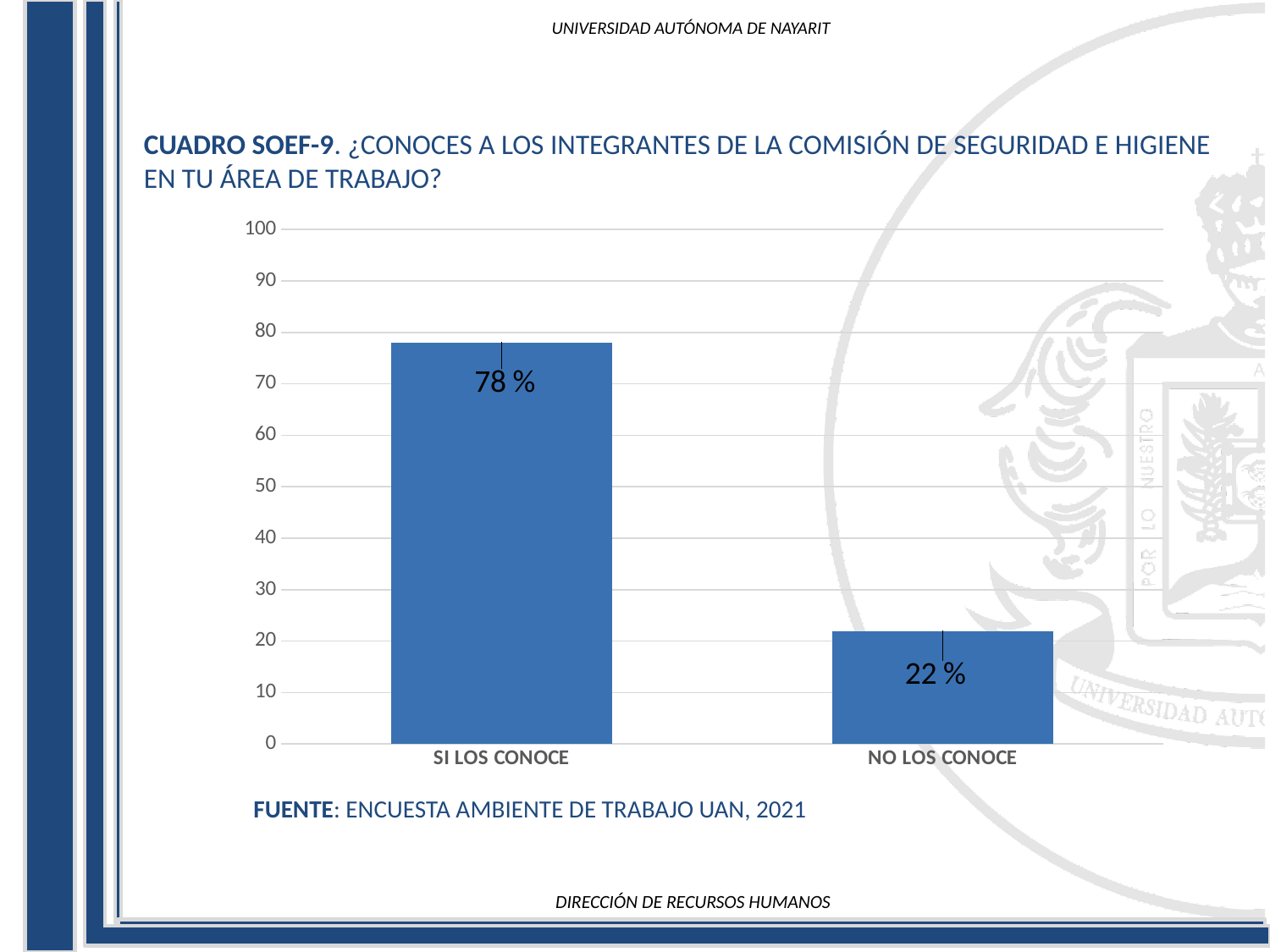
Is the value for SI LOS CONOCE greater or less than 70? greater Which is larger, the value for SI LOS CONOCE or the value for NO LOS CONOCE? SI LOS CONOCE Is the value for NO LOS CONOCE greater or less than 30? less What is the source cited below the chart? ENCUESTA AMBIENTE DE TRABAJO UAN, 2021 What is the value for SI LOS CONOCE? 78 % What is the value for NO LOS CONOCE? 22 % Which category has the highest value? SI LOS CONOCE What kind of chart is shown on the slide? bar chart Which category has the lowest value? NO LOS CONOCE What is the maximum value shown on the y axis? 100 How many categories are shown on the x axis? 2 What is the difference between the values for SI LOS CONOCE and NO LOS CONOCE? 56 %